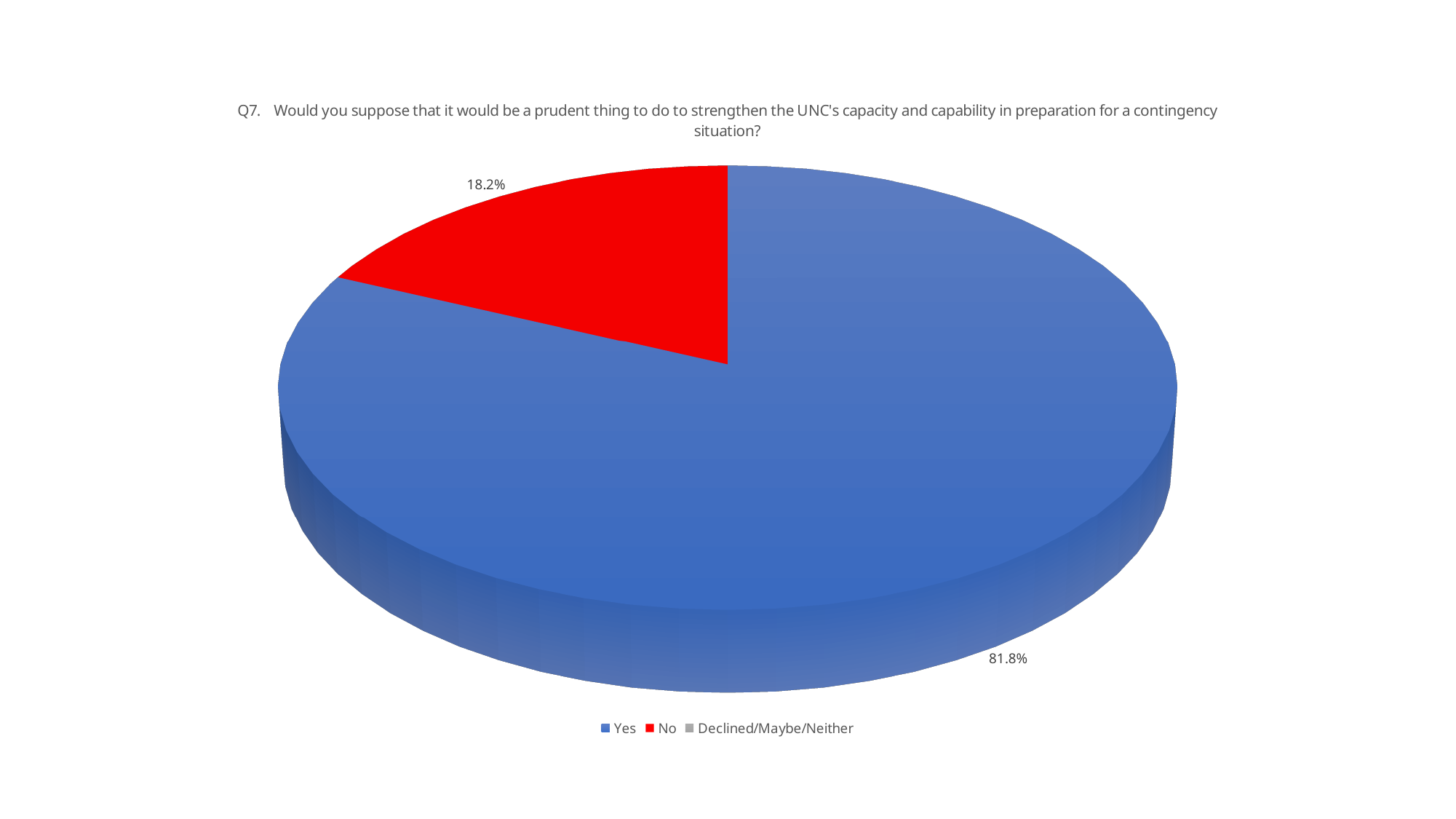
What colour is the Yes slice? Blue Which response has the largest share of the pie? Yes How many entries does the legend list? 3 Is the share for Yes greater or less than 50%? greater Is the share for No greater or less than 25%? less What is the difference in percentage points between the Yes and No shares? 63.6 What percentage of respondents answered No? 18.2% Which legend entry is shown in grey? Declined/Maybe/Neither What kind of chart is shown on the slide? Pie chart Which is larger, the Yes share or the No share? Yes What percentage of respondents answered Yes? 81.8% Which of the visible slices has the smallest share of the pie? No